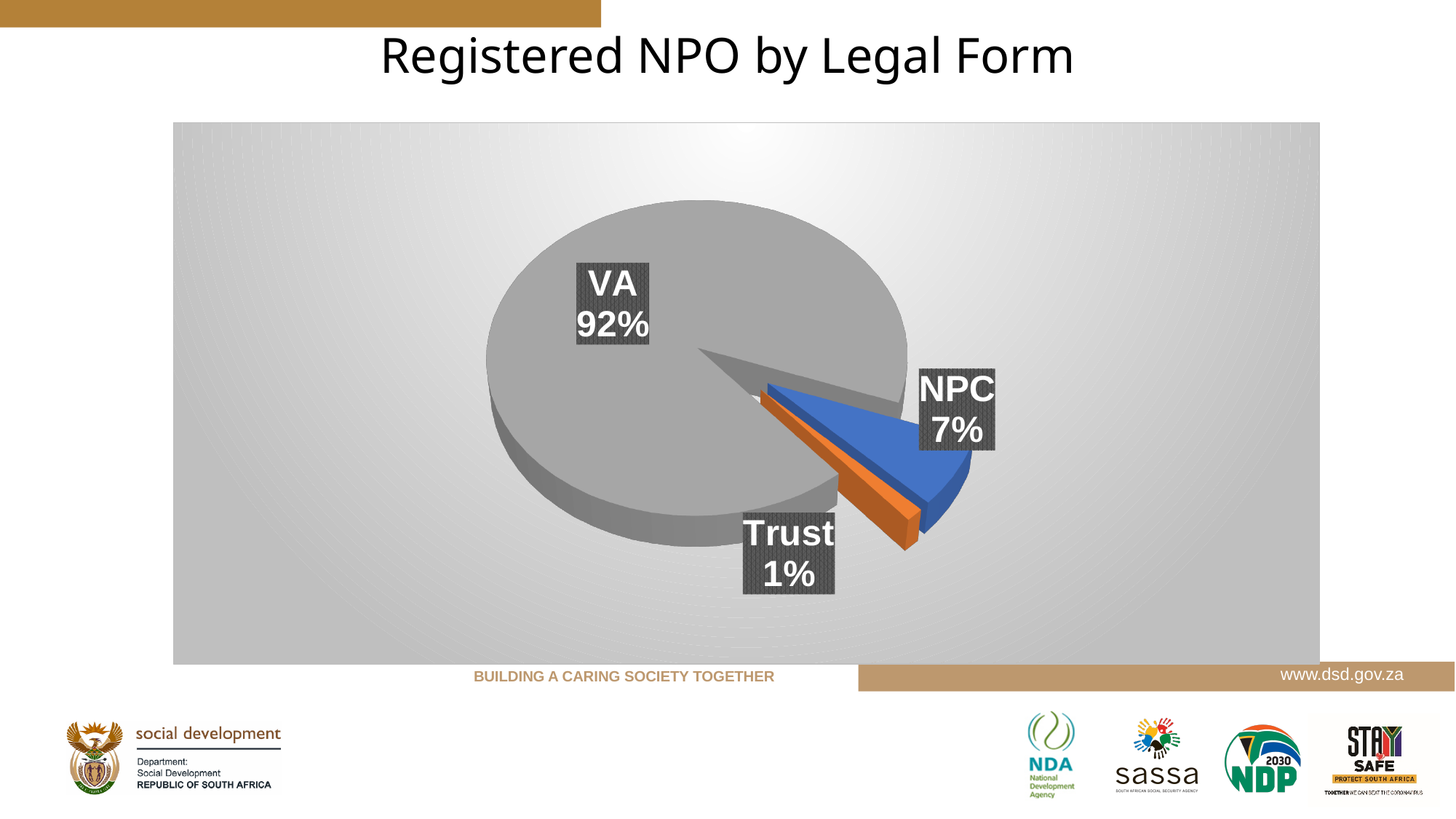
What colour is the NPC slice of the pie? Blue What is the title of the chart? Registered NPO by Legal Form Which has a larger share, NPC or Trust? NPC How many legal form categories are shown in the pie chart? 3 How many percentage points larger is the VA share than the NPC share? 85 What share of registered NPOs are Trusts? 1% Which legal form has the smallest share of registered NPOs? Trust What share of registered NPOs are VA (voluntary associations)? 92% Which legal form has the largest share of registered NPOs? VA How many percentage points larger is the NPC share than the Trust share? 6 What kind of chart is shown on the slide? Pie chart What share of registered NPOs are NPC? 7%